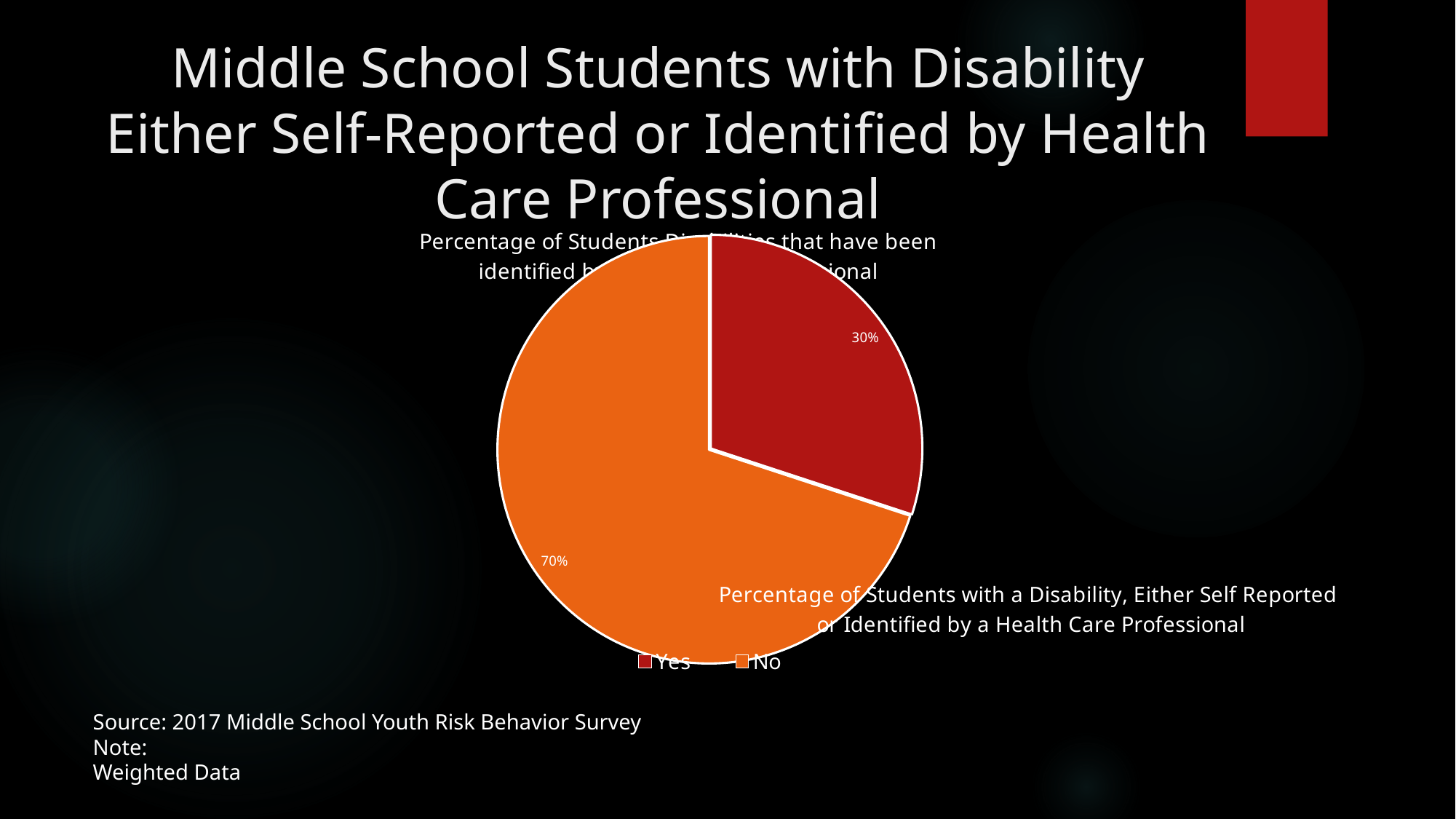
What percentage of the pie is the "No" slice? 70% How many slices does the pie chart have? 2 Which is larger, the "Yes" slice or the "No" slice? No Which slice of the pie is the largest? No How many entries does the legend list? 2 What is the difference in percentage points between the "No" slice and the "Yes" slice? 40 What are the two legend entries of the pie chart? Yes and No What percentage of the pie is the "Yes" slice? 30% Which slice of the pie is the smallest? Yes What colour is the "No" slice of the pie chart? orange What kind of chart is shown on the slide? pie chart